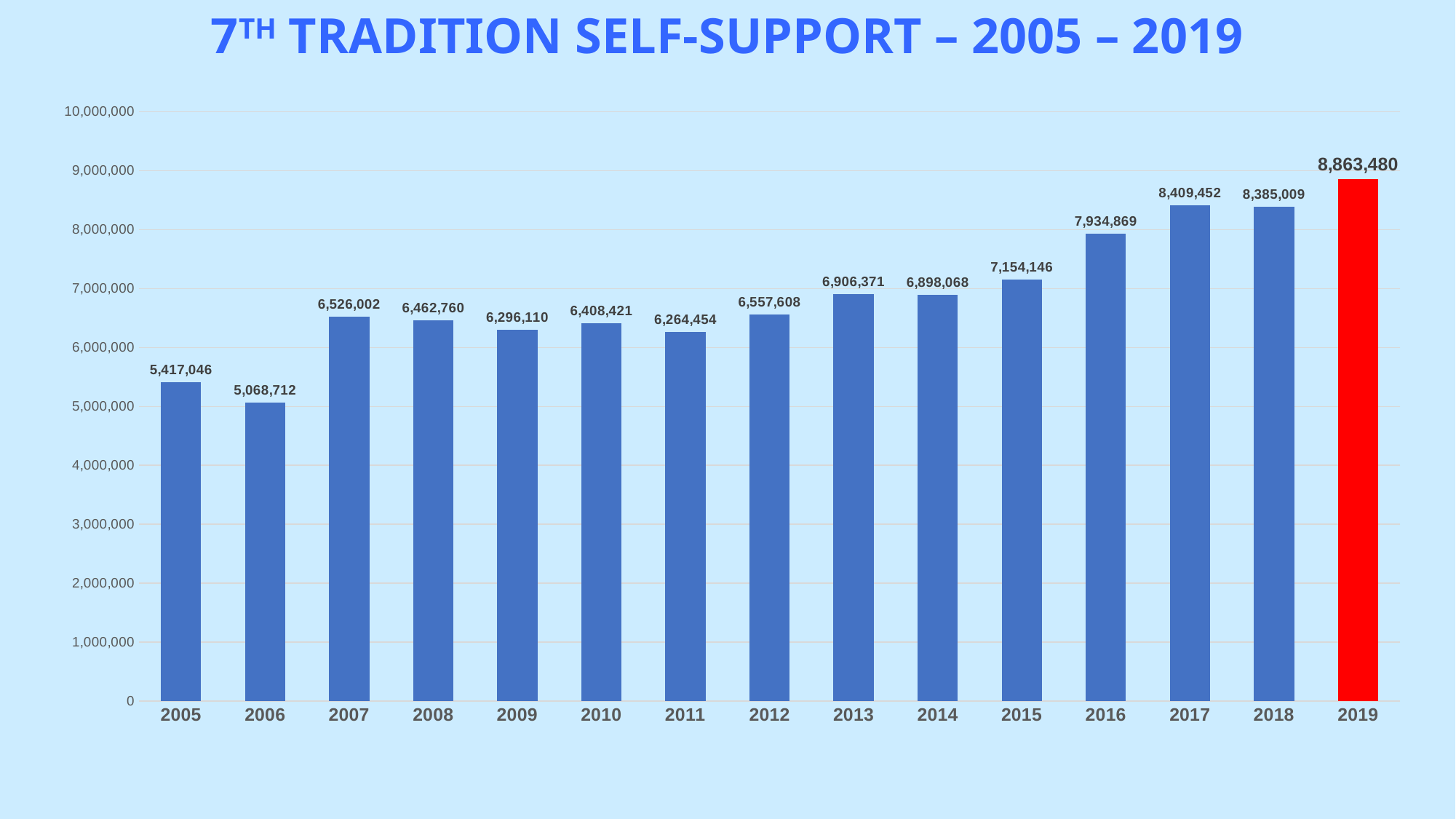
Which year has the lowest value? 2006 What kind of chart is this? bar chart What is the value for 2005? 5,417,046 Which is larger, the value for 2013 or the value for 2011? 2013 What is the difference between the values for 2005 and 2006? 348,334 Is the value for 2016 greater or less than 8,000,000? less Which year has the highest value? 2019 What is the difference between the values for 2019 and 2018? 478,471 What is the value for 2019? 8,863,480 What is the value for 2012? 6,557,608 Which bar is coloured red? 2019 How many years are shown on the x axis? 15